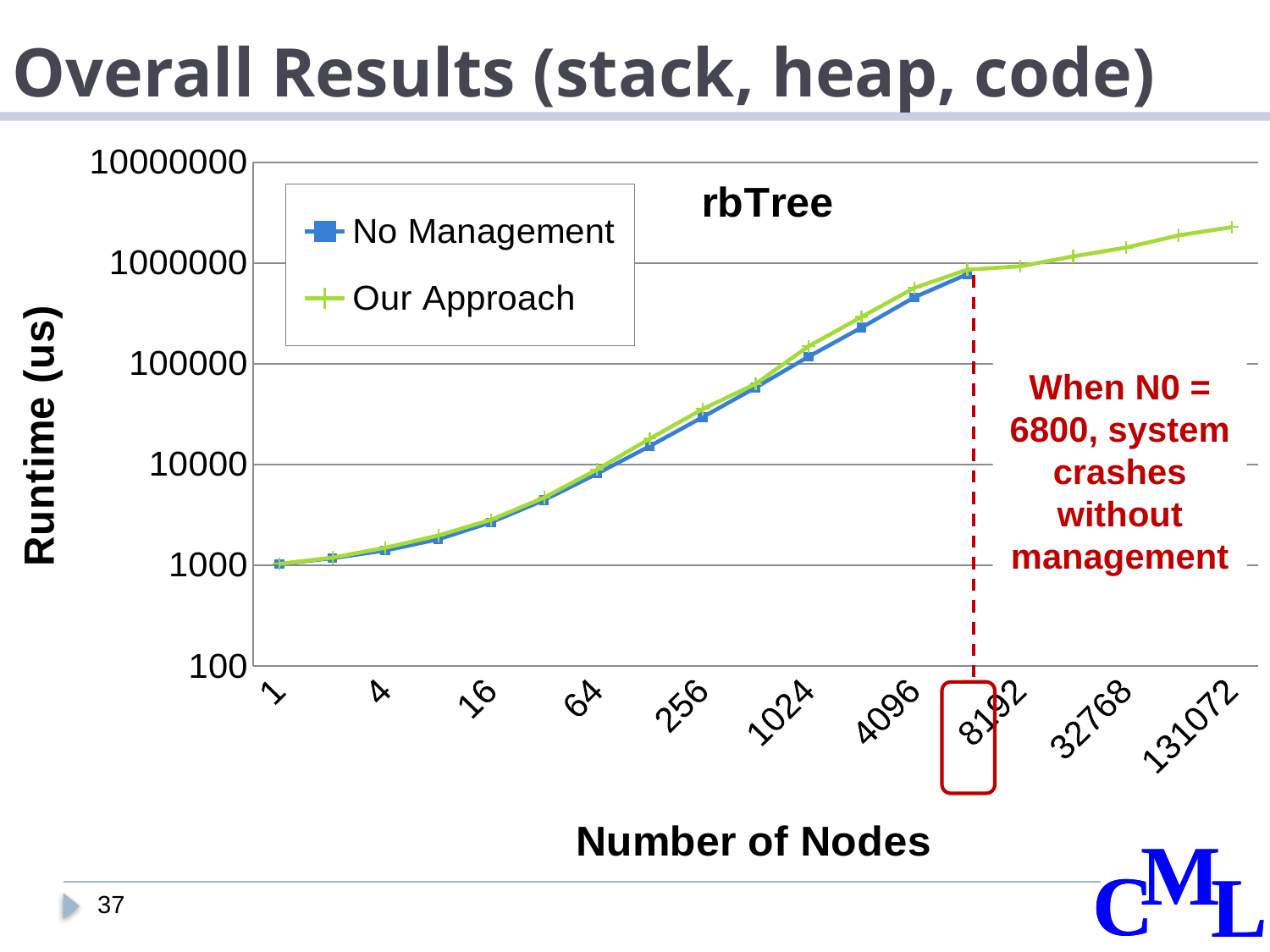
How many tick labels are shown on the x axis (Number of Nodes)? 10 What are the two series named in the legend? No Management and Our Approach What is the title shown inside the chart? rbTree At which number of nodes does Our Approach reach its highest runtime? 131072 Is the runtime for Our Approach at 131072 nodes greater or less than 1000000? greater How many series does the legend list? 2 Is the runtime for Our Approach at 256 nodes greater or less than 10000? greater Is the runtime for No Management at 16 nodes greater or less than 10000? less Does the runtime for Our Approach rise or fall as the number of nodes increases? rise At which number of nodes is the runtime for Our Approach lowest? 1 What kind of chart is shown on the slide? line chart